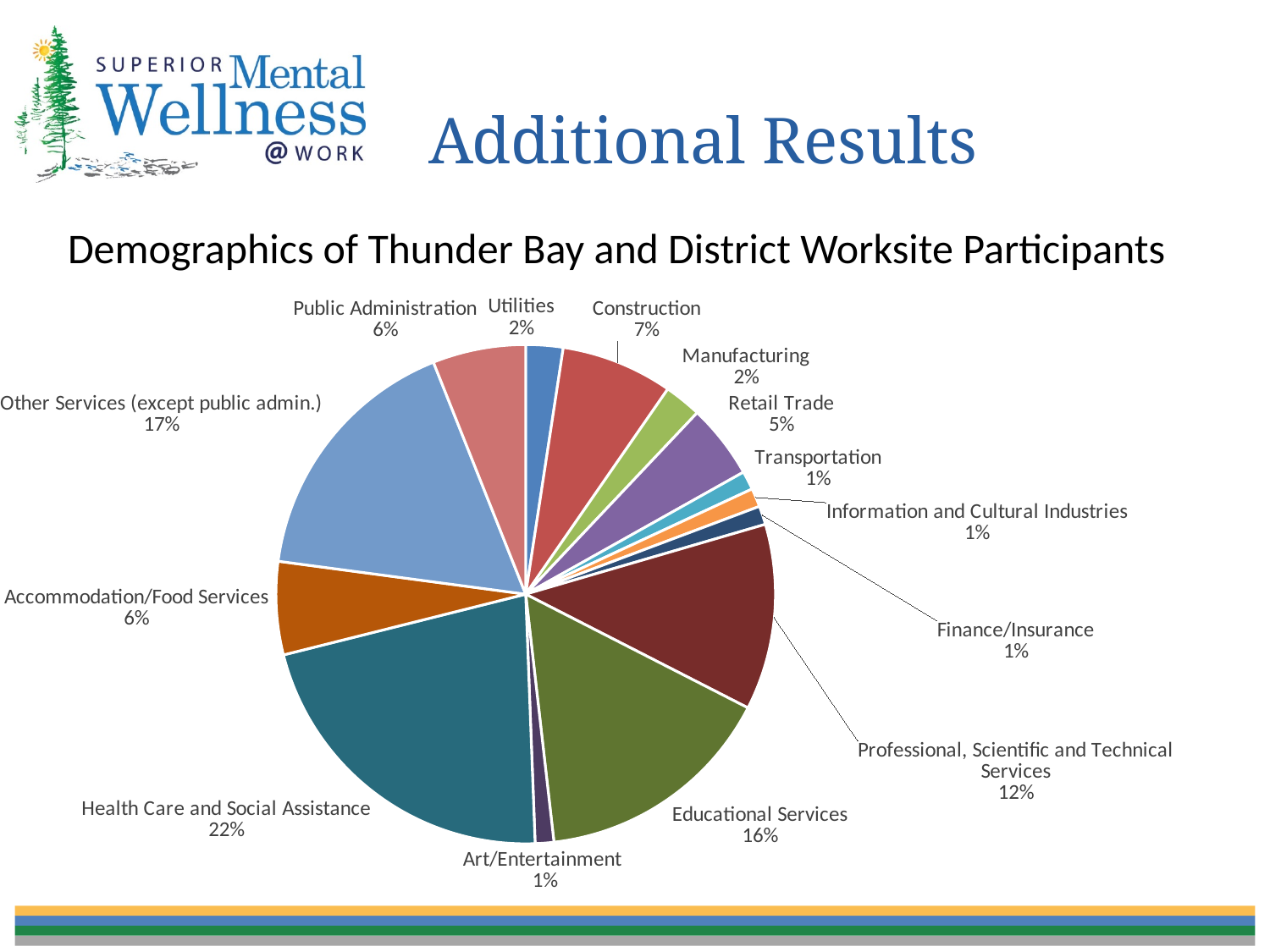
What is the title of the chart? Demographics of Thunder Bay and District Worksite Participants What share of the pie does Health Care and Social Assistance represent? 22% Which category has the largest share of the pie? Health Care and Social Assistance What percentage is shown for Other Services (except public admin.)? 17% What is the value for Professional, Scientific and Technical Services? 12% What is the difference in percentage points between Other Services (except public admin.) and Professional, Scientific and Technical Services? 5 percentage points Which is larger, Construction or Retail Trade? Construction What type of chart is shown on the slide? Pie chart What is the value shown for Educational Services? 16% What is the difference in percentage points between Health Care and Social Assistance and Educational Services? 6 percentage points How many categories are shown in the pie chart? 14 What percentage is shown for Construction? 7%